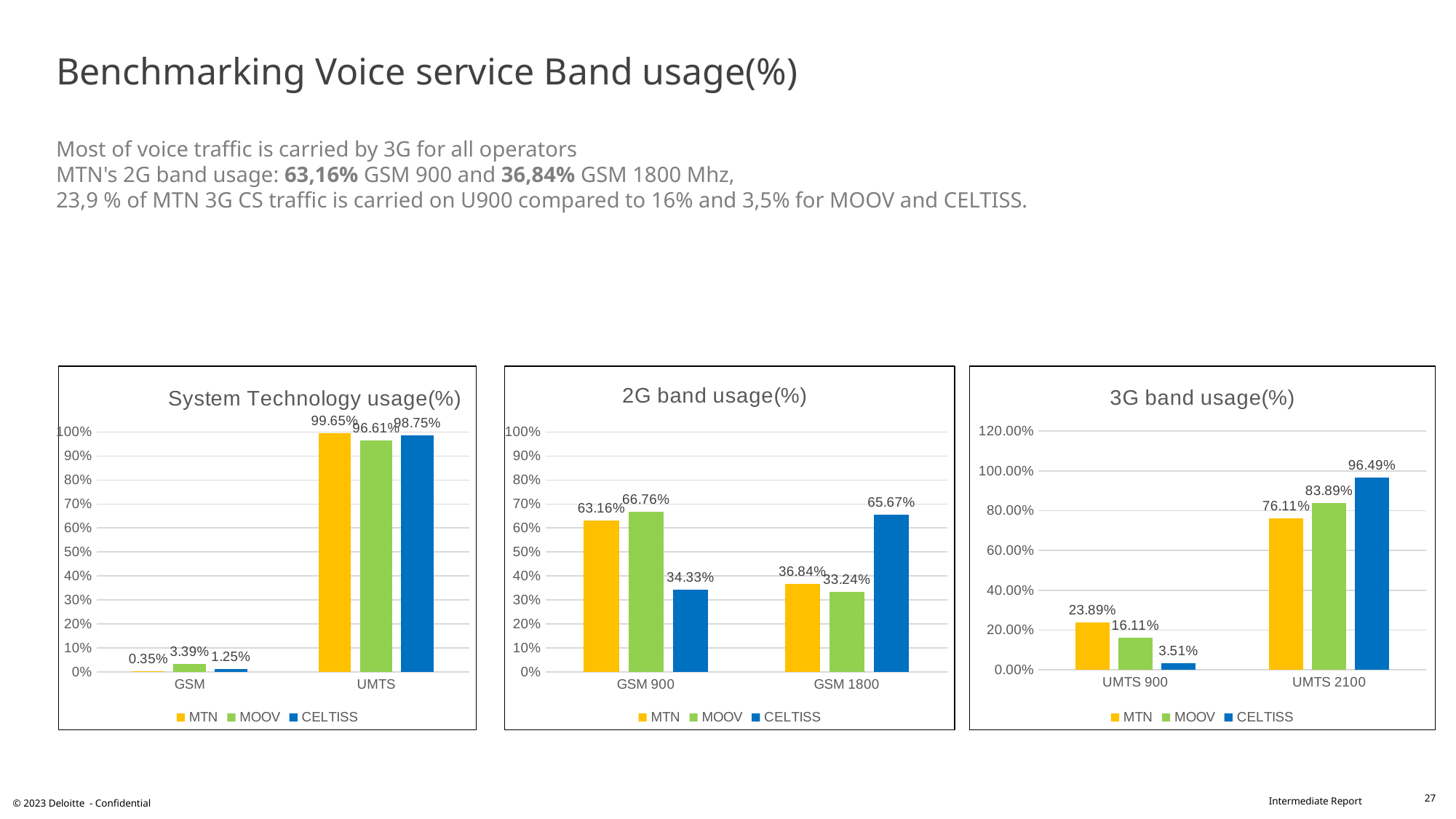
In the '3G band usage(%)' chart, which operator has the lowest value at UMTS 900? CELTISS In the '3G band usage(%)' chart, what is the difference between CELTISS and MTN at UMTS 2100? 20.38% What kind of chart is the '3G band usage(%)' chart? Bar chart How many categories are shown on the x axis of the 'System Technology usage(%)' chart? 2 In the '2G band usage(%)' chart, what is the value for CELTISS at GSM 1800? 65.67% In the 'System Technology usage(%)' chart, what is the value for MTN at UMTS? 99.65% In the '3G band usage(%)' chart, what is the value for MTN at UMTS 900? 23.89% In the '2G band usage(%)' chart, what is the difference between MTN's GSM 900 and GSM 1800 values? 26.32% In the '2G band usage(%)' chart, which operator has the highest value at GSM 900? MOOV In the '3G band usage(%)' chart, which is larger at UMTS 2100: MOOV or CELTISS? CELTISS In the 'System Technology usage(%)' chart, what is the value for MOOV at GSM? 3.39% How many series does the legend of the '2G band usage(%)' chart list? 3